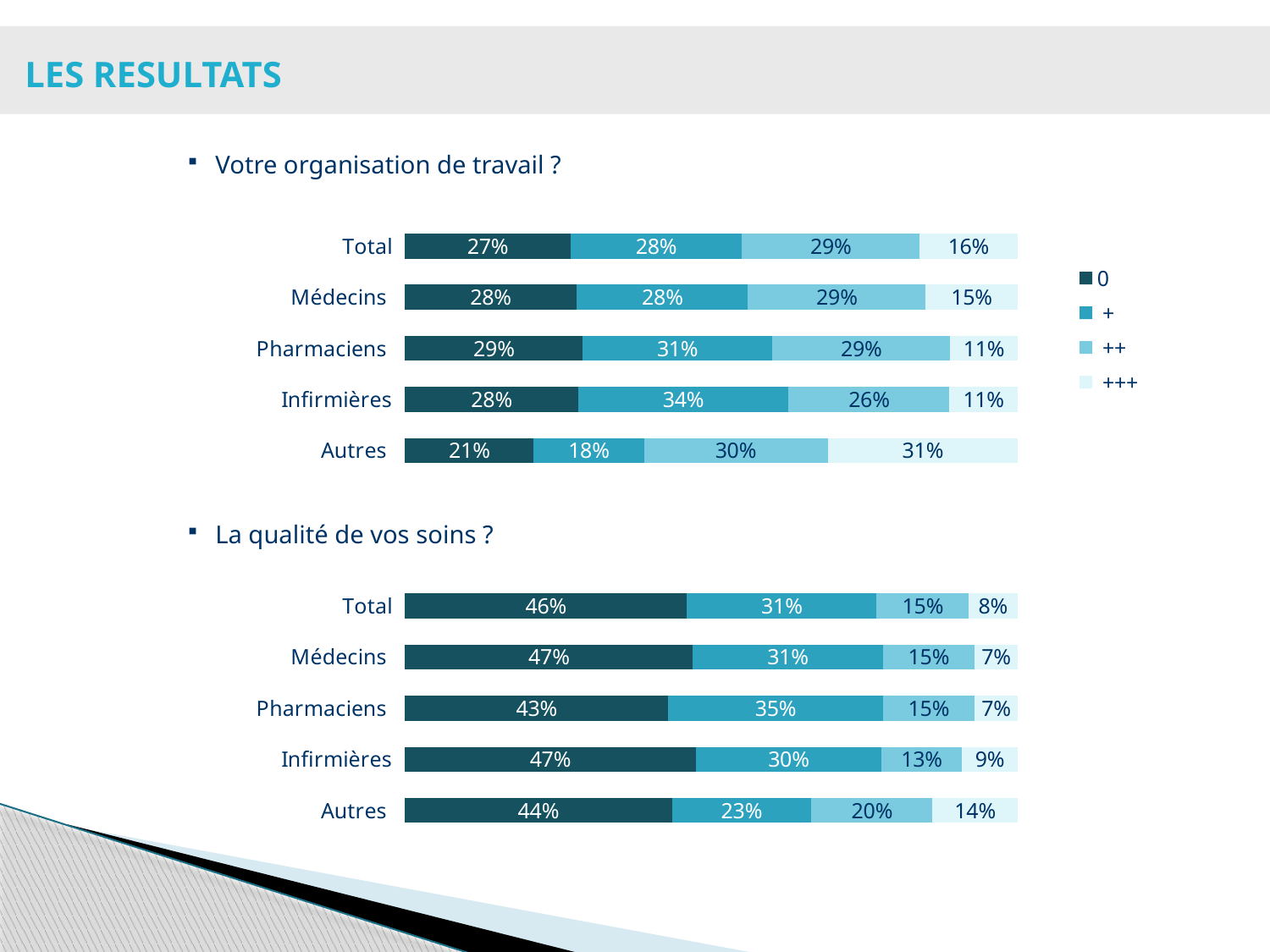
In the 'La qualité de vos soins ?' chart, which category has the lowest value in the second segment? Autres In the 'Votre organisation de travail ?' chart, how many series does the legend list? 4 In the 'La qualité de vos soins ?' chart, what is the value of the first (darkest) segment for Pharmaciens? 43% In the 'La qualité de vos soins ?' chart, what is the value of the last (lightest) segment for Autres? 14% In the 'Votre organisation de travail ?' chart, what is the difference between the '+++' values for Total and Pharmaciens? 5% In the 'Votre organisation de travail ?' chart, what is the value of the '0' segment for Pharmaciens? 29% In the 'Votre organisation de travail ?' chart, what is the value of the '+++' segment for Autres? 31% In the 'La qualité de vos soins ?' chart, is the first segment larger for Médecins or for Pharmaciens? Médecins In the 'Votre organisation de travail ?' chart, which category has the lowest '0' value? Autres In the 'Votre organisation de travail ?' chart, which category has the highest '+' value? Infirmières What type of chart is used for 'Votre organisation de travail ?'? Stacked bar chart How many categories are shown in the 'La qualité de vos soins ?' chart? 5